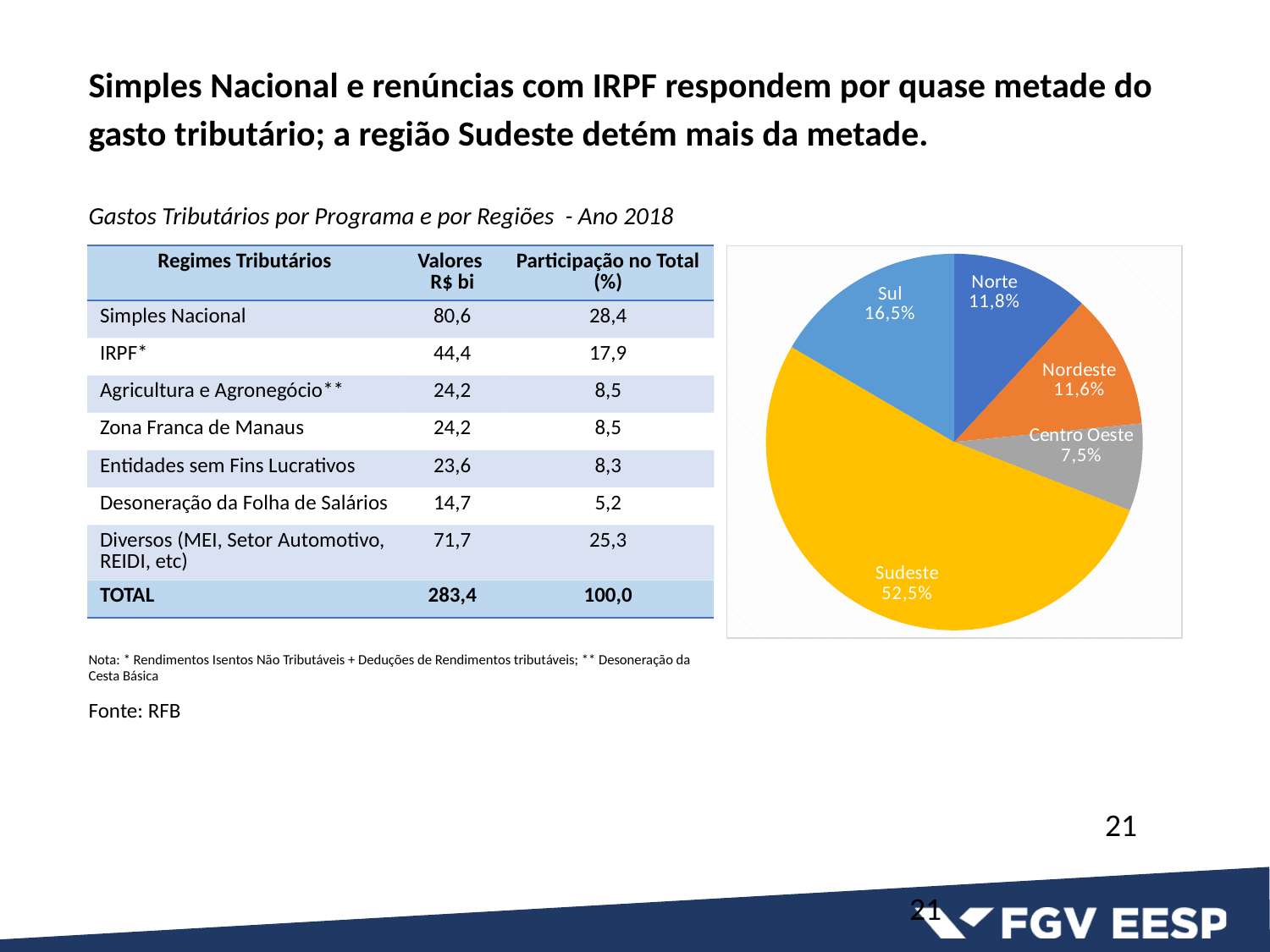
In the pie chart, what is the value shown for Norte? 11,8% In the pie chart, what is the difference between the shares of Sul and Nordeste? 4,9% In the pie chart, what is the value shown for Sul? 16,5% In the pie chart, what share does Sudeste hold? 52,5% How many regions (slices) are shown in the pie chart? 5 In the pie chart, which slice is larger: Sul or Norte? Sul Which region has the largest slice in the pie chart? Sudeste What type of chart is shown on the right side of the slide? pie chart In the pie chart, what is the value shown for Centro Oeste? 7,5% Which region has the smallest slice in the pie chart? Centro Oeste What colour is the Sudeste slice in the pie chart? yellow In the pie chart, what is the difference between the shares of Sudeste and Centro Oeste? 45,0%